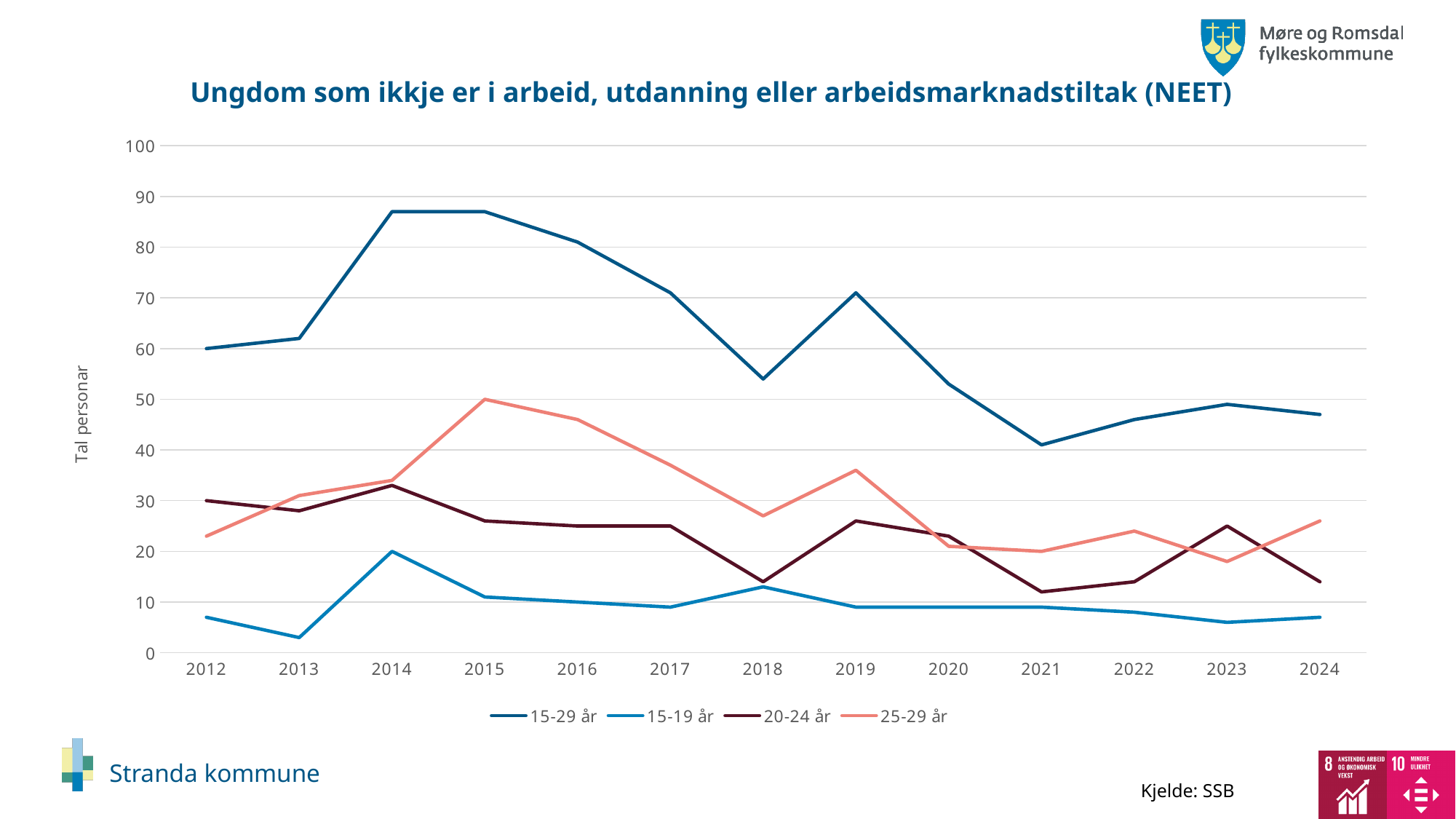
Does the value for 15-29 år rise or fall from 2015 to 2018? fall What is the label on the y axis? Tal personar In 2024, which is larger: the value for 25-29 år or the value for 20-24 år? 25-29 år Is the value for 15-29 år in 2018 greater or less than 50? greater In which year is the value for 15-19 år lowest? 2013 Is the value for 15-19 år in 2023 greater or less than 10? less What kind of chart is shown on the slide? line chart What is the value for 25-29 år in 2015? 50 What is the value for 15-29 år in 2012? 60 How many series does the legend list? 4 In which year is the value for 25-29 år highest? 2015 How many years are shown along the x axis? 13